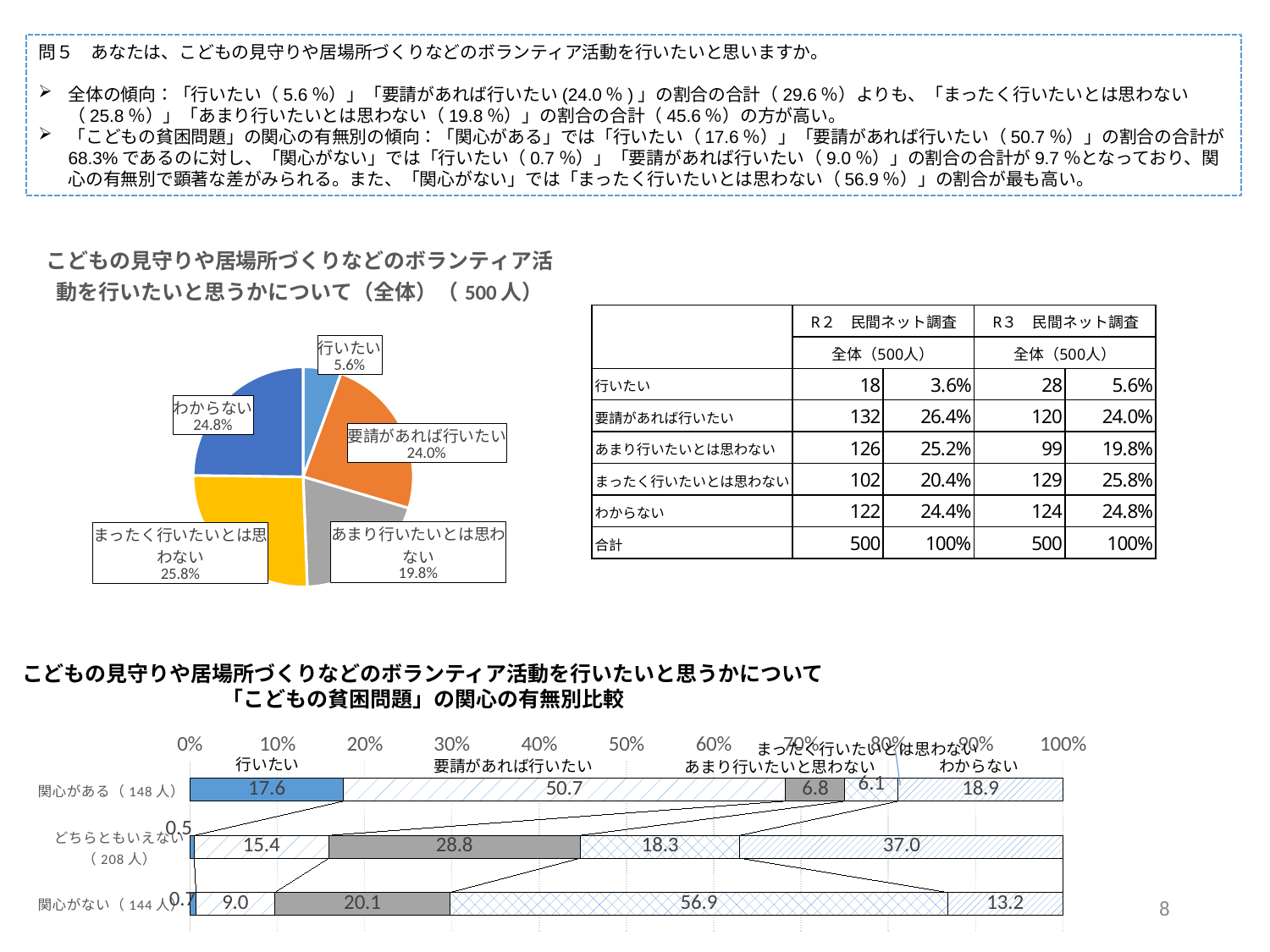
How many slices does the pie chart (全体, 500人) have? 5 In the pie chart (全体, 500人), which category has the smallest share? 行いたい What kind of chart is the bottom chart (関心の有無別比較)? Stacked horizontal bar chart In the pie chart (全体, 500人), what is the difference between まったく行いたいとは思わない and あまり行いたいとは思わない? 6.0 percentage points What kind of chart is the upper chart on the slide (全体, 500人)? Pie chart In the bottom bar chart (関心の有無別比較), what is the value for 要請があれば行いたい in the 関心がある group? 50.7 In the bottom bar chart (関心の有無別比較), what is the value for まったく行いたいとは思わない in the 関心がない group? 56.9 In the pie chart (全体, 500人), what is the value for 行いたい? 5.6% How many groups (bars) are shown in the bottom bar chart (関心の有無別比較)? 3 How many series does the bottom bar chart (関心の有無別比較) show? 5 In the bottom bar chart (関心の有無別比較), which group has the larger value for 行いたい, 関心がある or 関心がない? 関心がある In the pie chart (全体, 500人), which category has the largest share? まったく行いたいとは思わない